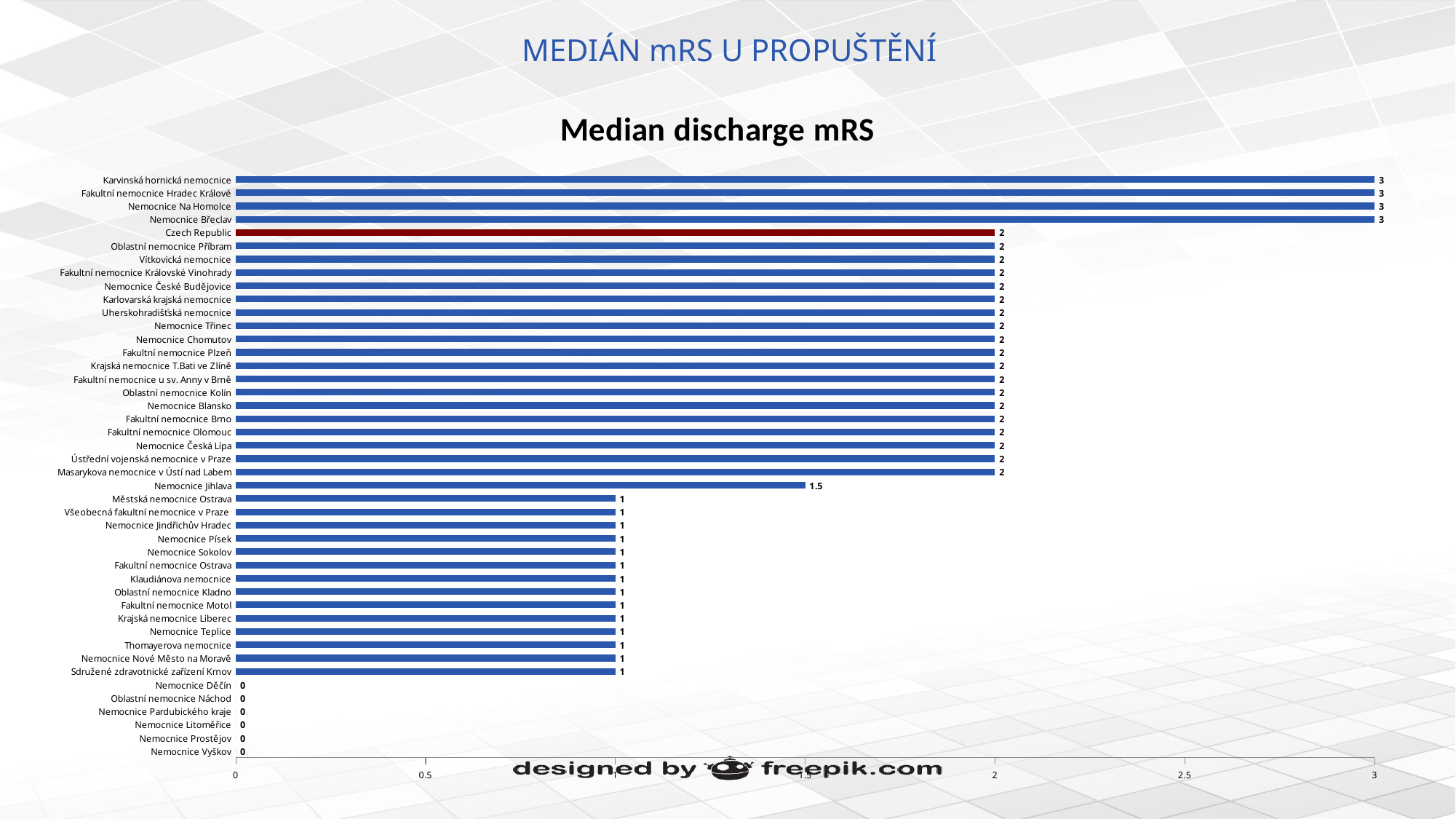
What is the median discharge mRS for Fakultní nemocnice Motol? 1 What kind of chart is shown on the slide? Bar chart What is the median discharge mRS for Nemocnice Jihlava? 1.5 What is the median discharge mRS for Nemocnice Na Homolce? 3 How many categories are shown in the chart? 44 Is the value for Nemocnice Jihlava greater or less than 1? greater What is the median discharge mRS for Czech Republic? 2 Which has a higher median discharge mRS, Fakultní nemocnice Brno or Nemocnice Teplice? Fakultní nemocnice Brno What is the difference between the median discharge mRS of Karvinská hornická nemocnice and Nemocnice Jihlava? 1.5 What is the median discharge mRS for Nemocnice Vyškov? 0 Which category's bar is coloured dark red instead of blue? Czech Republic What is the title of the chart? Median discharge mRS